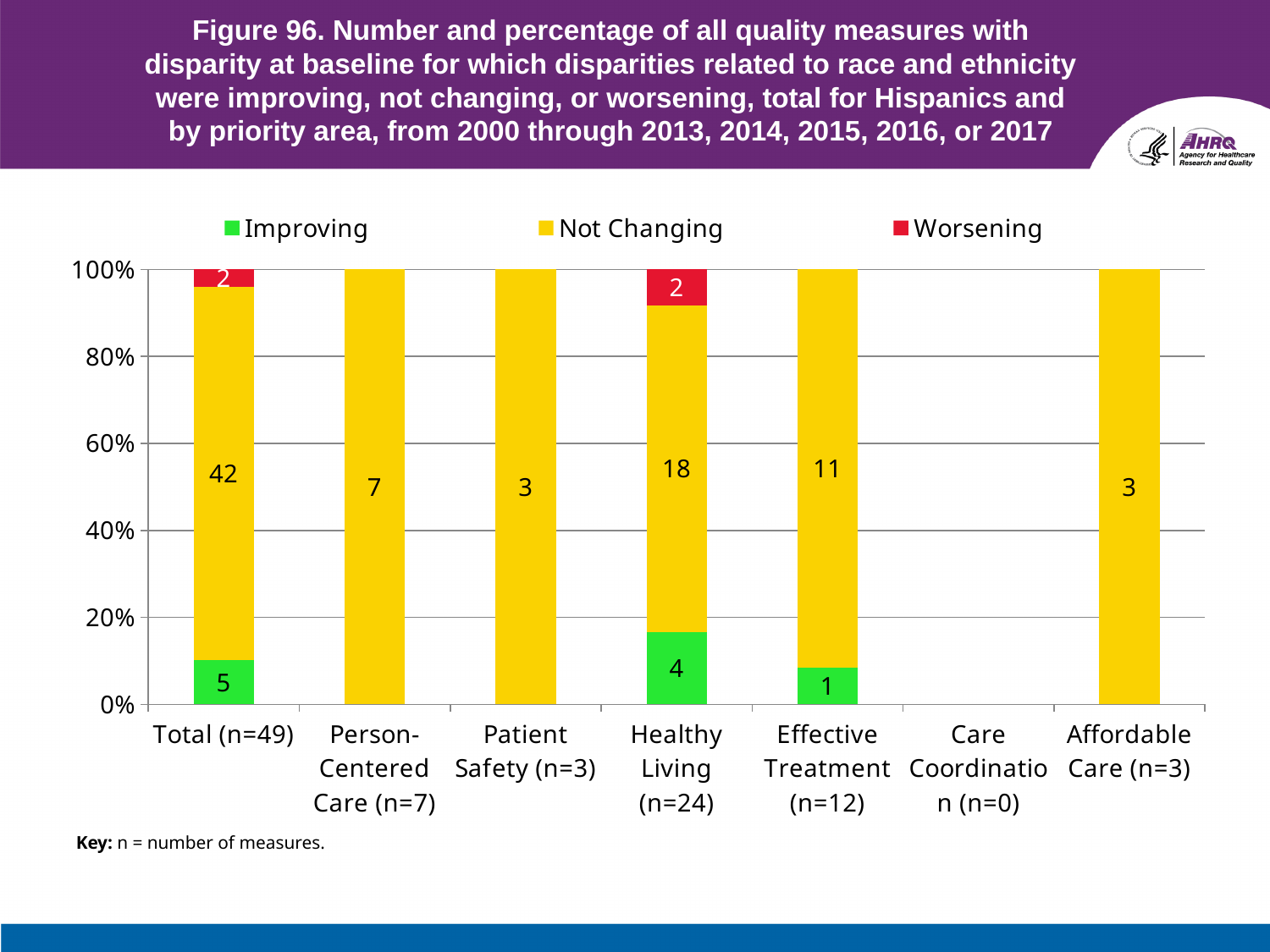
How many series does the legend list? 3 Which colour represents the Worsening series? Red What kind of chart is shown on the slide? Stacked bar chart What is the Improving value for Healthy Living (n=24)? 4 What is the Improving value for Effective Treatment (n=12)? 1 What is the Not Changing value for Effective Treatment (n=12)? 11 What is the difference between the Not Changing values for Healthy Living (n=24) and Effective Treatment (n=12)? 7 What is the Not Changing value for Total (n=49)? 42 Which category has the highest Not Changing value? Total (n=49) What is the Worsening value for Healthy Living (n=24)? 2 Which is larger, the Improving value for Total (n=49) or the Improving value for Healthy Living (n=24)? Total (n=49) How many categories are shown on the x axis? 7